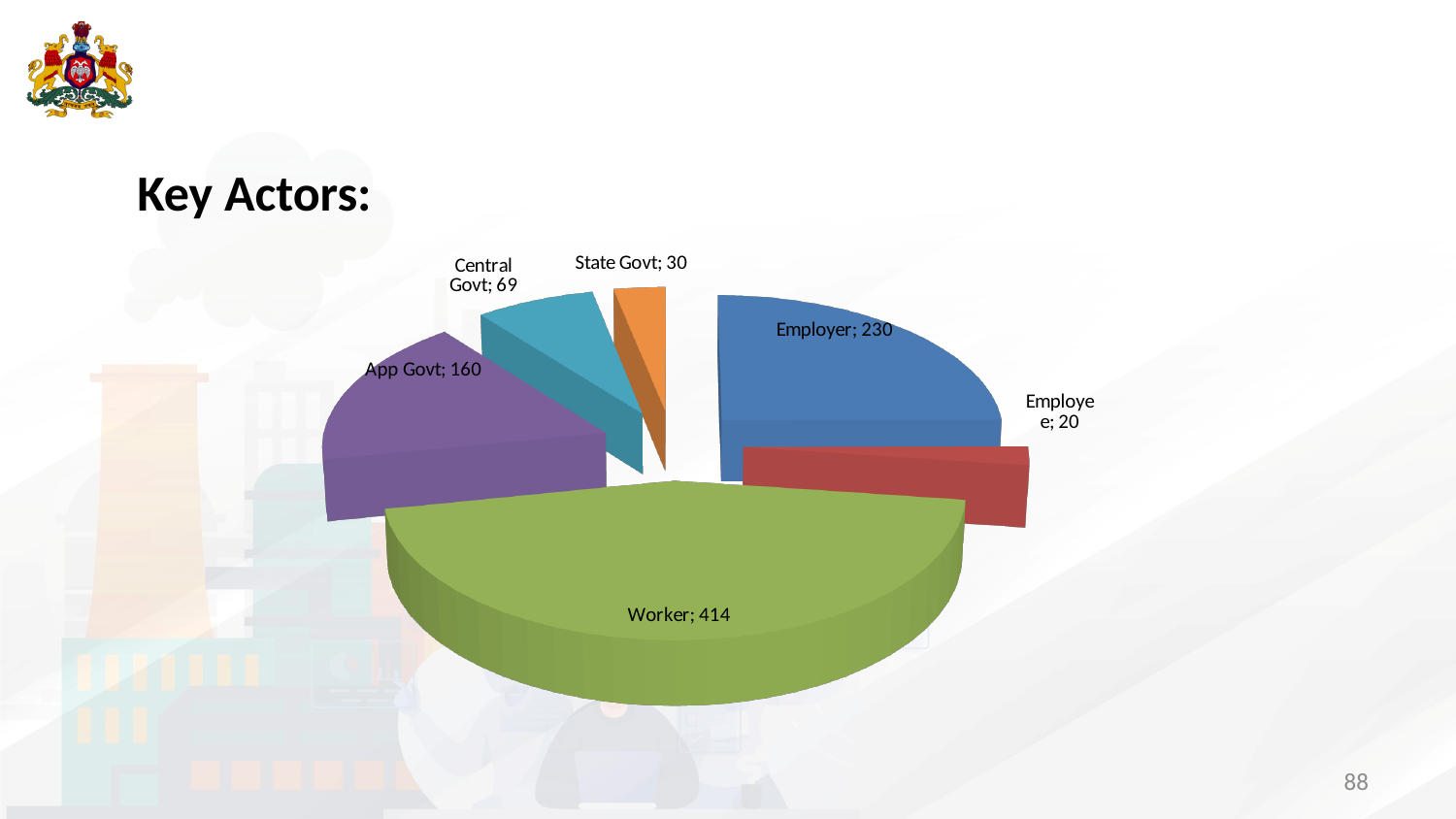
Which category has the largest slice? Worker What is the value for App Govt? 160 Which category has the smallest slice? Employee What is the difference between the values for Worker and Employer? 184 What is the value for State Govt? 30 What is the value for Employer? 230 What kind of chart is shown on the slide? Pie chart What is the value for Worker? 414 What is the value for Central Govt? 69 Which is larger, the value for App Govt or the value for Central Govt? App Govt How many categories does the pie chart show? 6 What is the title of the slide containing the pie chart? Key Actors: